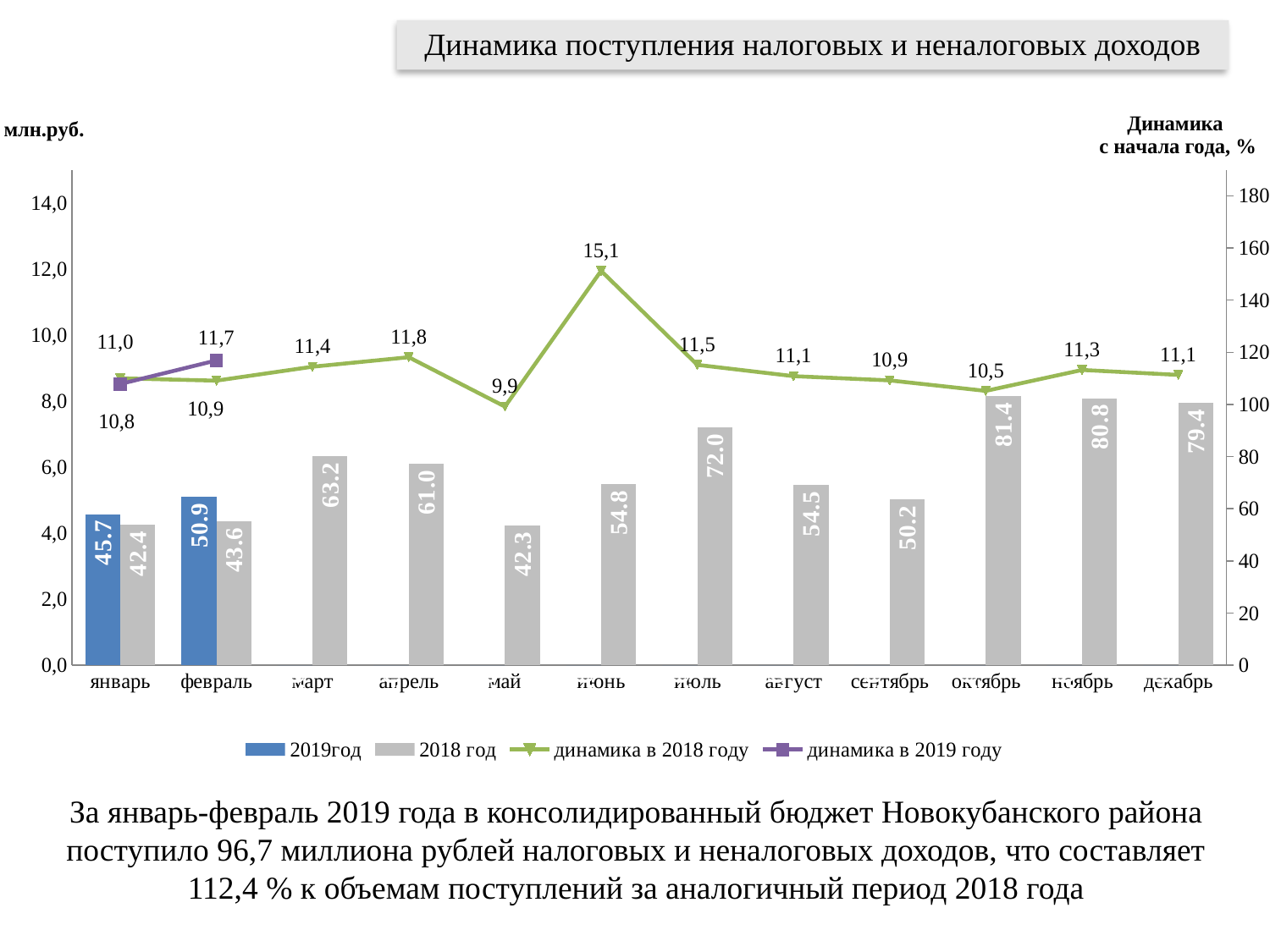
What kind of chart is this? Combined bar and line chart What is the value of the 2019год bar for февраль? 50.9 What is the value of the 2018 год bar for октябрь? 81.4 Which month has the lowest 2018 год bar? май How many series does the legend list? 4 What is the value of the динамика в 2019 году line for январь? 10,8 What is the title of the chart? Динамика поступления налоговых и неналоговых доходов How many months are shown on the x axis? 12 What is the difference between the 2019год and 2018 год bars for январь? 3.3 What is the value of the динамика в 2018 году line for июнь? 15,1 Which month has the highest 2018 год bar? октябрь Which is larger for февраль: the 2019год bar or the 2018 год bar? 2019год